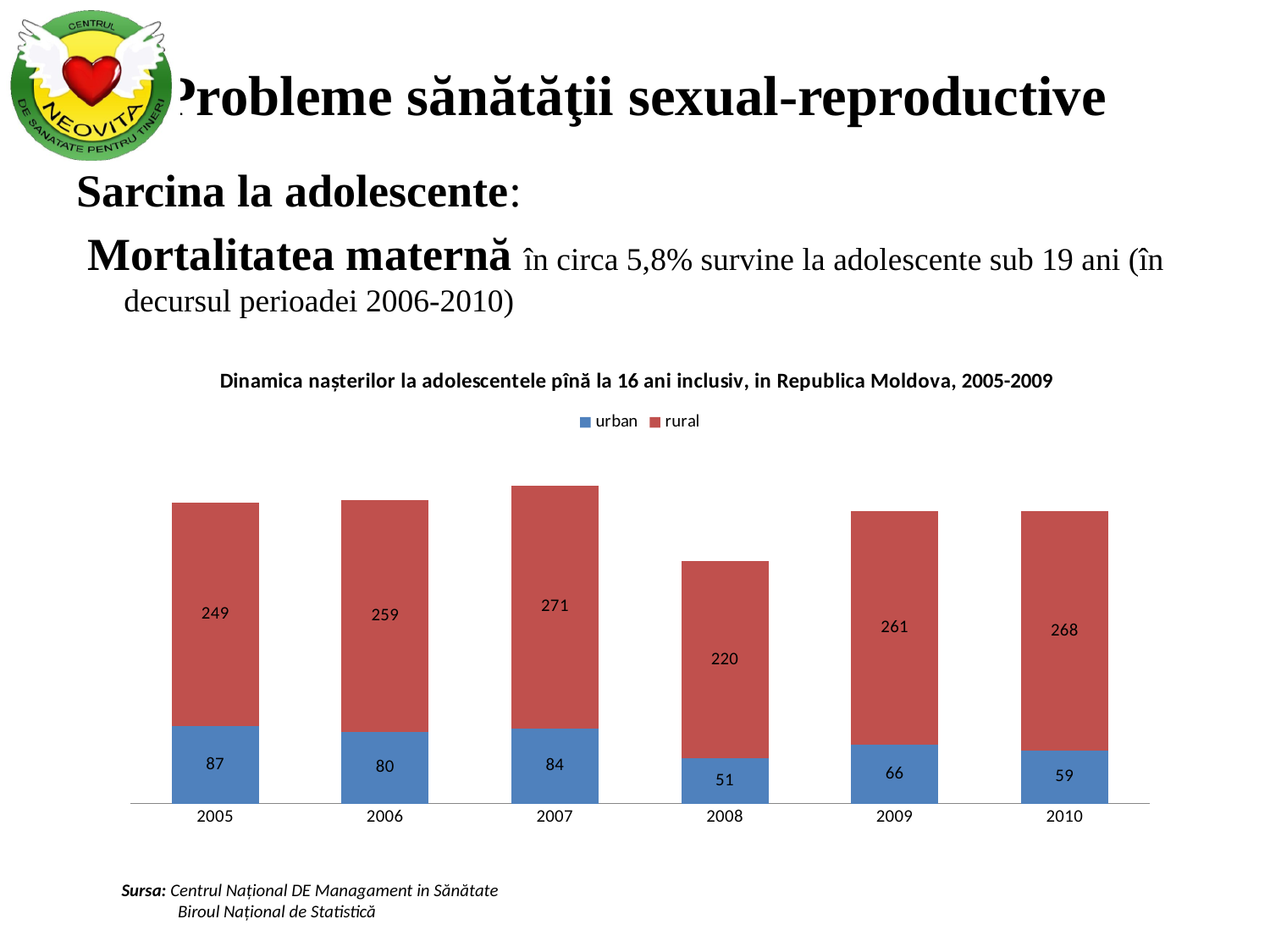
Which year has the lowest urban value? 2008 What is the rural value for 2010? 268 Which colour represents the rural series? red Which is larger, the urban value for 2009 or the urban value for 2010? 2009 What is the urban value for 2005? 87 How many series does the legend list? 2 How many years are shown on the x axis? 6 What is the rural value for 2008? 220 What is the total of the stacked bar for 2006? 339 What is the difference between the rural values for 2007 and 2008? 51 Which year has the highest rural value? 2007 What kind of chart is shown? stacked bar chart